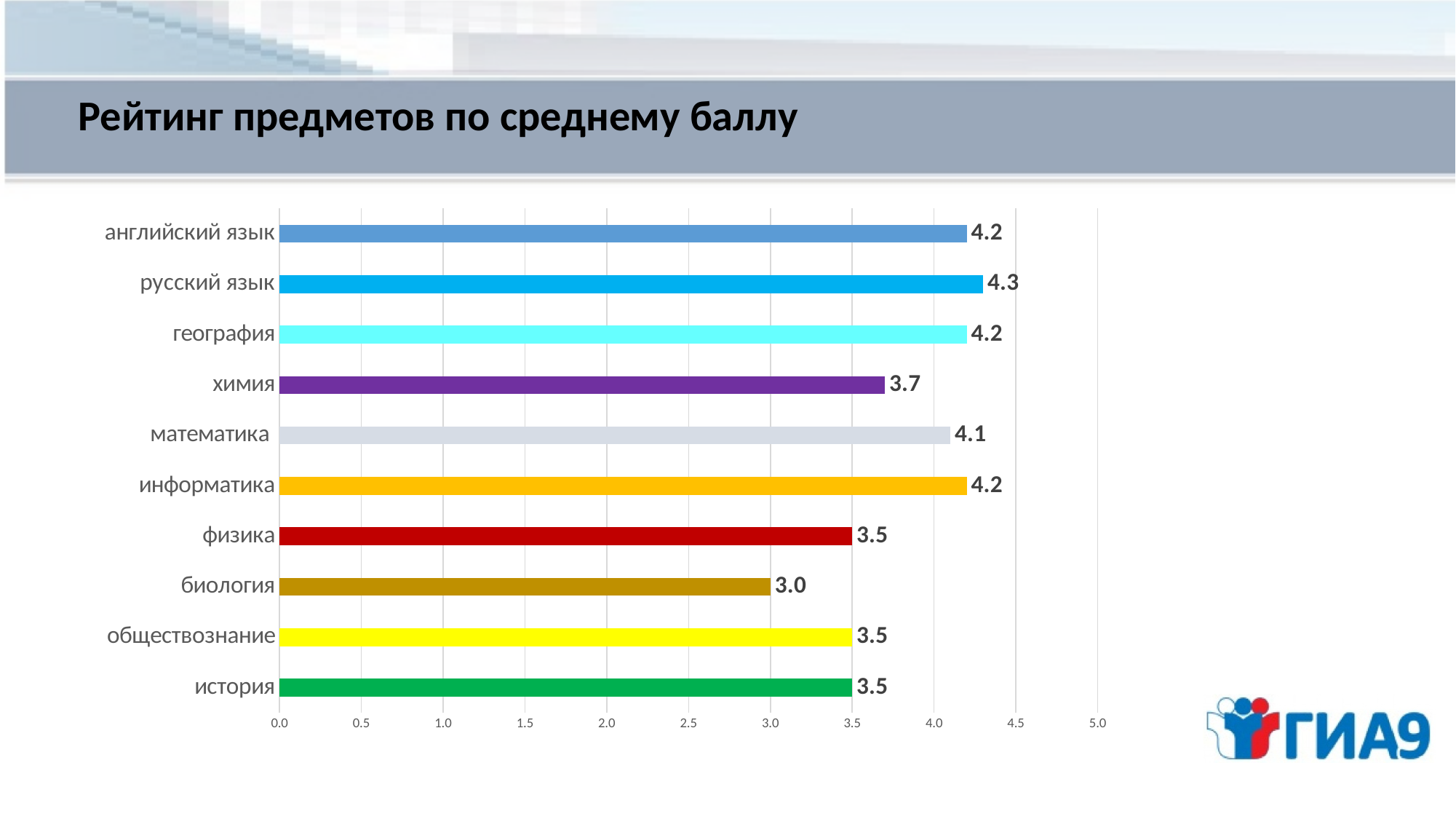
What type of chart is shown on the slide? bar chart What is the average score for химия? 3.7 Which has a higher average score, математика or химия? математика Which subject has the highest average score? русский язык What is the average score for биология? 3.0 What is the title of the chart? Рейтинг предметов по среднему баллу What is the average score for русский язык? 4.3 Which subject has the lowest average score? биология What is the average score for математика? 4.1 What is the difference between the average scores for химия and физика? 0.2 What is the difference between the average scores for русский язык and биология? 1.3 How many subjects are shown in the chart? 10